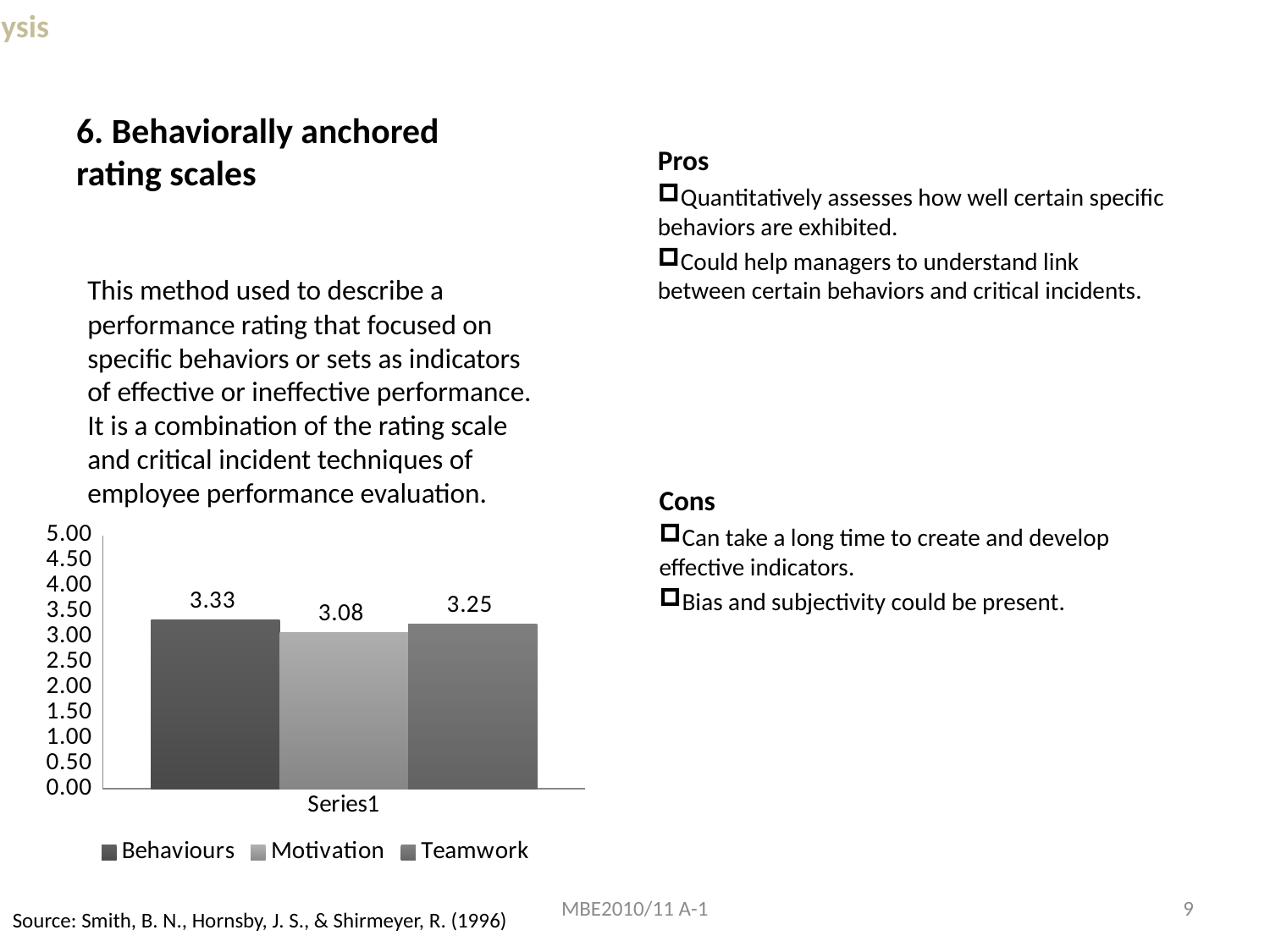
What is the value for Teamwork in the chart? 3.25 Is the value for Motivation greater or less than 3.50? less What kind of chart is shown on the slide? bar chart Which is larger, the value for Behaviours or the value for Teamwork? Behaviours What is the value for Motivation in the chart? 3.08 What is the difference between the values for Teamwork and Motivation? 0.17 Which series has the highest value in the chart? Behaviours How many series does the legend list? 3 What is the difference between the values for Behaviours and Motivation? 0.25 What is the value for Behaviours in the chart? 3.33 What is the category label shown on the x axis of the chart? Series1 Which series has the lowest value in the chart? Motivation